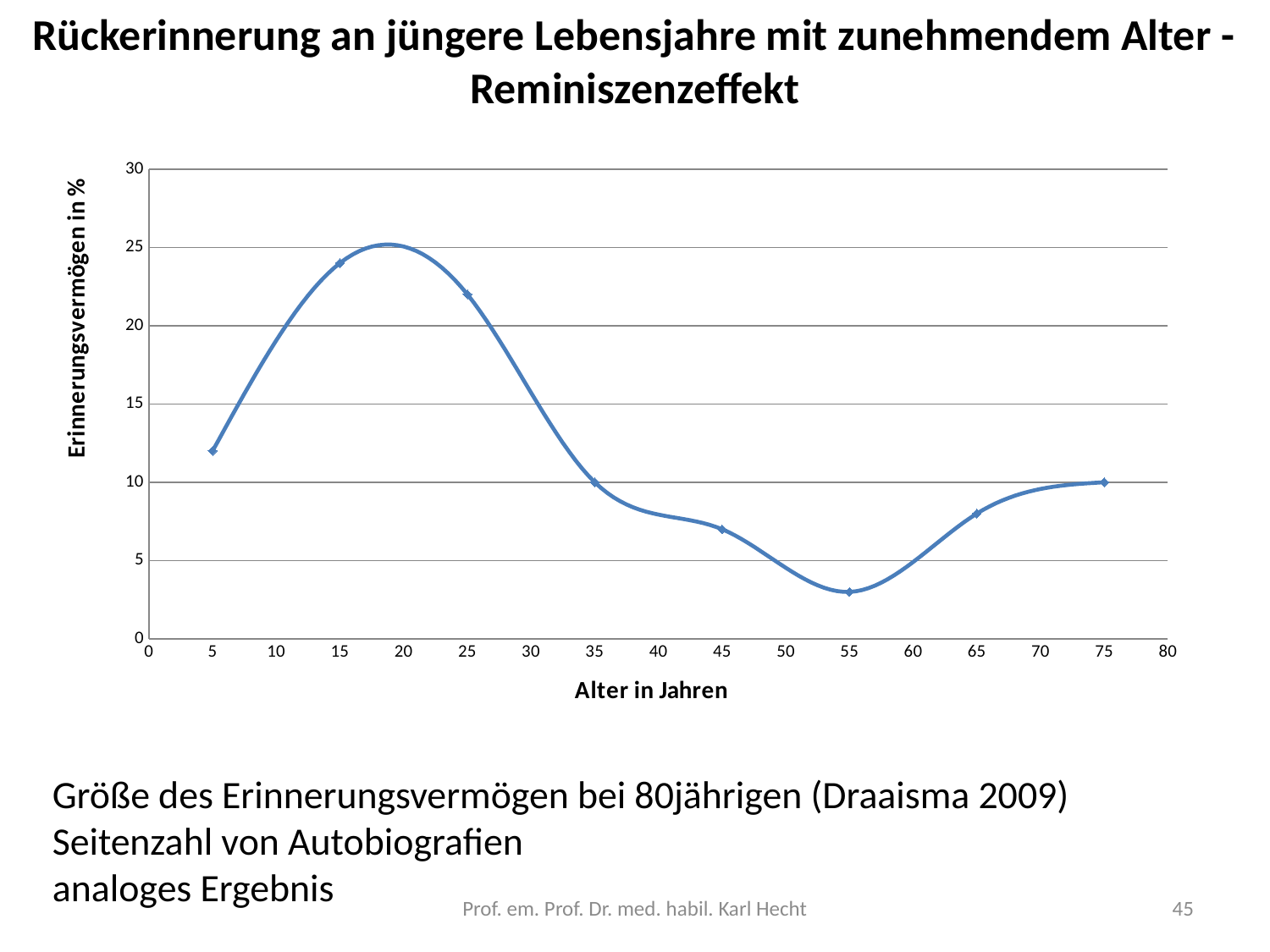
Is the value at age 15 greater or less than 20? greater At which age (Alter in Jahren) is the Erinnerungsvermögen highest? 15 What is the Erinnerungsvermögen in % at age 35? 10 What is the Erinnerungsvermögen in % at age 75? 10 Do the values rise or fall between age 25 and age 55? fall Which is larger, the value at age 5 or the value at age 45? age 5 At which age (Alter in Jahren) is the Erinnerungsvermögen lowest? 55 Is the value at age 5 greater or less than 10? greater What kind of chart is shown on the slide? line chart What is the label of the x axis? Alter in Jahren How many data points are plotted on the line? 8 Is the value at age 55 greater or less than 5? less